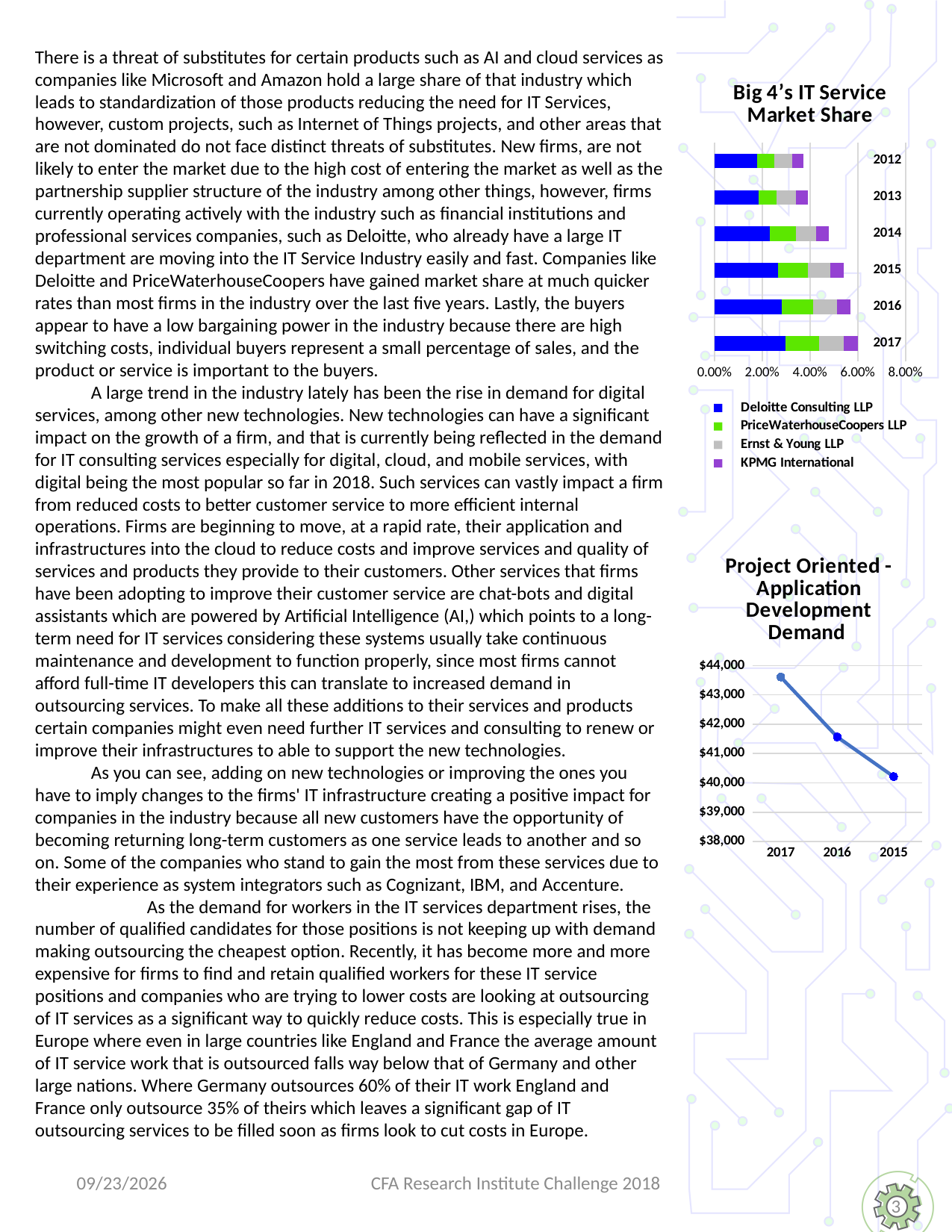
What kind of chart is the 'Project Oriented - Application Development Demand' chart? Line chart How many data points are plotted on the 'Project Oriented - Application Development Demand' chart? 3 In the 'Project Oriented - Application Development Demand' chart, is the value for 2017 greater or less than $43,000? greater In the 'Big 4's IT Service Market Share' chart, which year has the longest total bar? 2017 In the 'Project Oriented - Application Development Demand' chart, is the value for 2015 greater or less than $41,000? less In the 'Project Oriented - Application Development Demand' chart, which is larger, the value for 2017 or the value for 2015? 2017 How many series does the legend of the 'Big 4's IT Service Market Share' chart list? 4 In the 'Big 4's IT Service Market Share' chart, which year has the shortest total bar? 2012 In the 'Big 4's IT Service Market Share' chart, which series is shown in blue? Deloitte Consulting LLP How many years are shown on the 'Big 4's IT Service Market Share' chart? 6 What kind of chart is the 'Big 4's IT Service Market Share' chart? Stacked bar chart